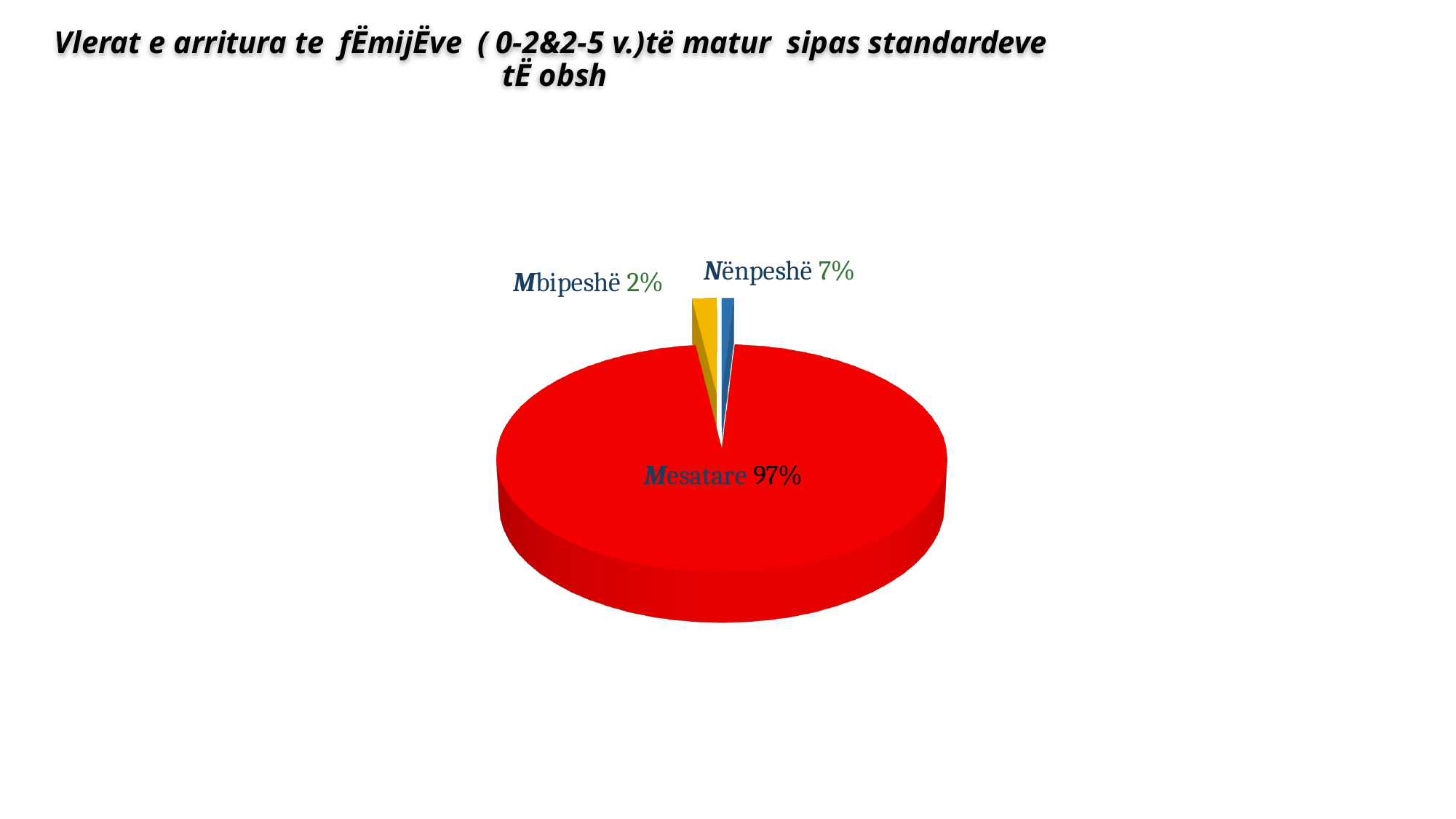
How many slices does the pie chart have? 3 What colour is the Mesatare slice? Red What percentage is shown for Nënpeshë? 7% Which category has the largest slice of the pie? Mesatare What colour is the Mbipeshë slice? Yellow What percentage is shown for Mbipeshë? 2% What kind of chart is shown on the slide? Pie chart What percentage is shown for Mesatare? 97%